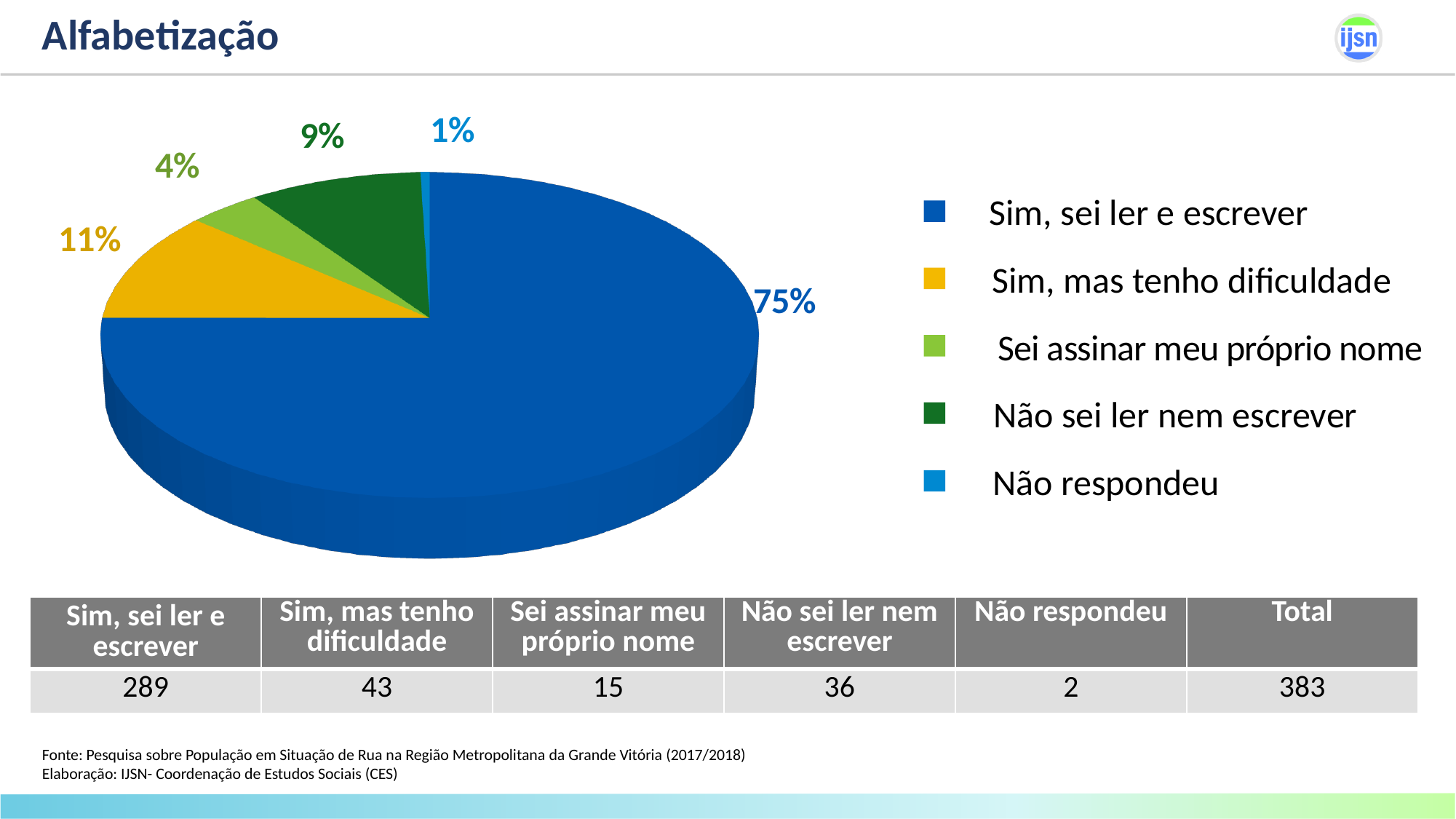
What percentage of the pie chart is labelled for "Não respondeu"? 1% What percentage of the pie chart is labelled for "Não sei ler nem escrever"? 9% How many categories does the legend of the pie chart list? 5 What type of chart is shown on the slide? Pie chart What colour is the slice for "Sim, mas tenho dificuldade" in the pie chart? Yellow What percentage of the pie chart is labelled for "Sei assinar meu próprio nome"? 4% What is the difference in percentage points between the "Sim, mas tenho dificuldade" slice and the "Não sei ler nem escrever" slice? 2 percentage points Which slice is larger: "Sei assinar meu próprio nome" or "Não sei ler nem escrever"? Não sei ler nem escrever Which category has the smallest slice of the pie chart? Não respondeu Which category has the largest slice of the pie chart? Sim, sei ler e escrever What percentage of the pie chart is labelled for "Sim, sei ler e escrever"? 75% What percentage of the pie chart is labelled for "Sim, mas tenho dificuldade"? 11%